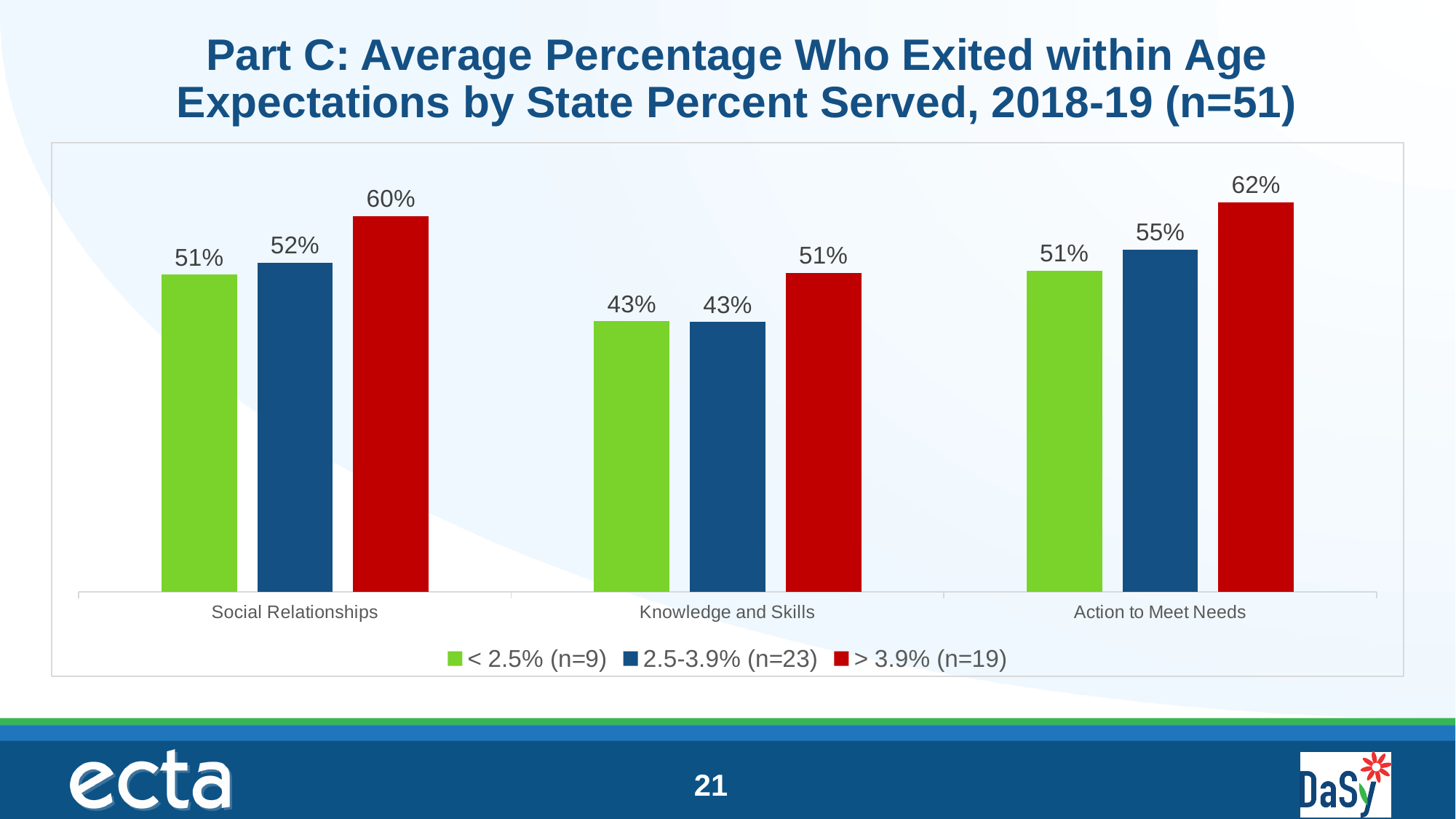
What is the value for the > 3.9% (n=19) series in the Action to Meet Needs category? 62% Which category has the lowest value for the 2.5-3.9% (n=23) series? Knowledge and Skills Which colour represents the > 3.9% (n=19) series? Red What is the value for the 2.5-3.9% (n=23) series in the Social Relationships category? 52% Which category has the highest value for the > 3.9% (n=19) series? Action to Meet Needs What is the value for the < 2.5% (n=9) series in the Knowledge and Skills category? 43% What kind of chart is shown on the slide? Bar chart What is the difference between the > 3.9% (n=19) value and the < 2.5% (n=9) value in the Social Relationships category? 9% How many categories are shown on the x axis? 3 In the Action to Meet Needs category, which is larger: the 2.5-3.9% (n=23) value or the < 2.5% (n=9) value? 2.5-3.9% (n=23) How many series does the legend list? 3 What is the difference between the > 3.9% (n=19) value and the 2.5-3.9% (n=23) value in the Knowledge and Skills category? 8%